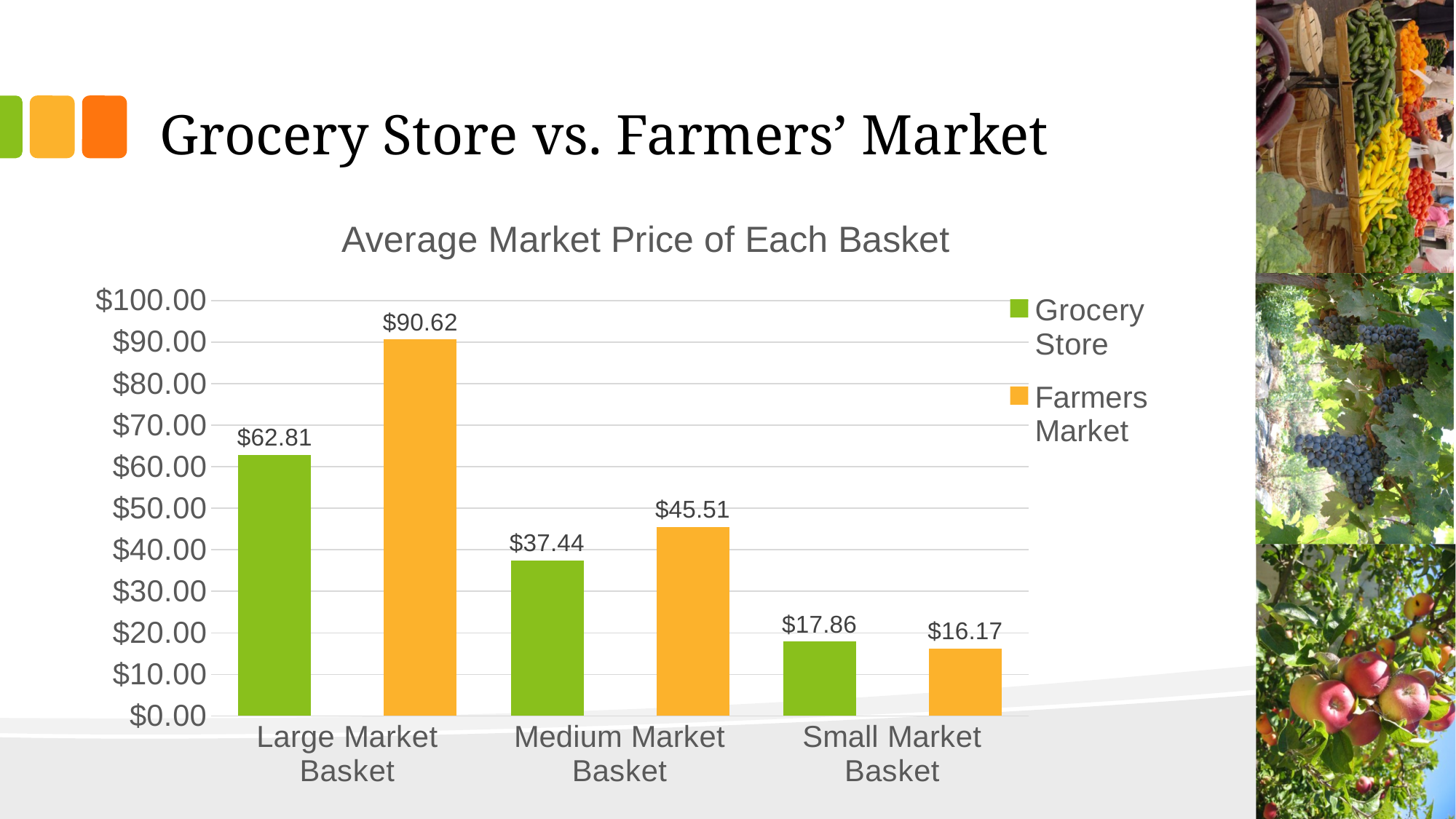
Which basket has the highest Farmers Market price? Large Market Basket For the Small Market Basket, which is larger: the Grocery Store price or the Farmers Market price? Grocery Store What kind of chart is shown on the slide? Bar chart What is the difference between the Farmers Market and Grocery Store prices for the Large Market Basket? $27.81 Which basket has the lowest Grocery Store price? Small Market Basket What is the Grocery Store value for the Large Market Basket? $62.81 Is the Grocery Store value for the Medium Market Basket greater or less than $40.00? less What is the Farmers Market value for the Small Market Basket? $16.17 What is the title of the chart? Average Market Price of Each Basket What is the Farmers Market value for the Medium Market Basket? $45.51 How many basket categories are shown on the x axis? 3 How many series does the legend list? 2